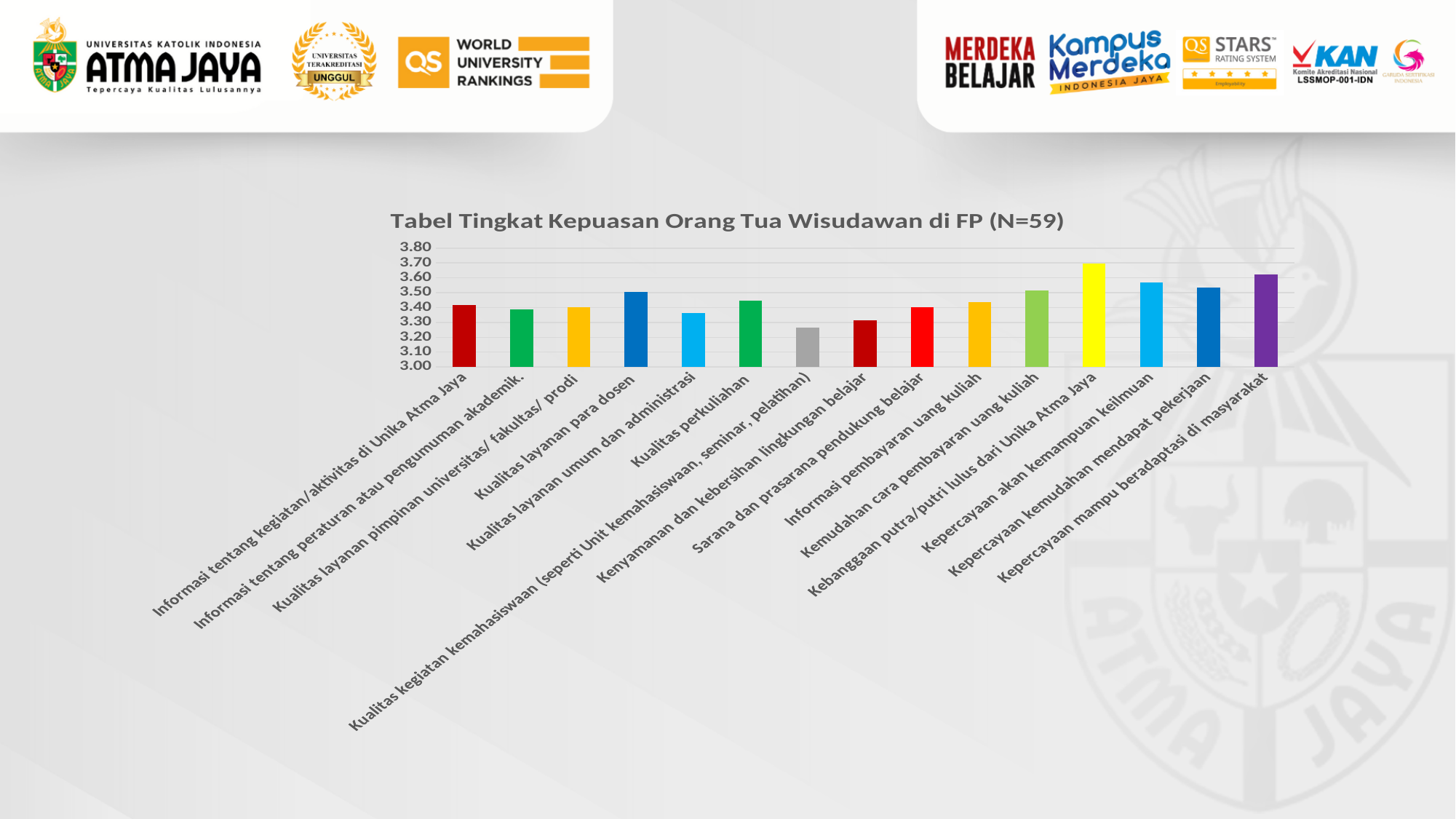
Is the value for Kualitas layanan umum dan administrasi greater or less than 3.40? less Which is larger: the value for Kualitas layanan para dosen or the value for Kualitas layanan umum dan administrasi? Kualitas layanan para dosen What is the highest value shown on the vertical axis of the chart? 3.80 Is the value for Kepercayaan mampu beradaptasi di masyarakat greater or less than 3.50? greater Which category has the lowest value in the chart? Kualitas kegiatan kemahasiswaan (seperti Unit kemahasiswaan, seminar, pelatihan) Is the value for Kualitas kegiatan kemahasiswaan (seperti Unit kemahasiswaan, seminar, pelatihan) greater or less than 3.30? less How many categories (bars) are plotted in the chart? 15 What is the title of the chart? Tabel Tingkat Kepuasan Orang Tua Wisudawan di FP (N=59) Which is larger: the value for Kepercayaan akan kemampuan keilmuan or the value for Kualitas perkuliahan? Kepercayaan akan kemampuan keilmuan Which category has the highest value in the chart? Kebanggaan putra/putri lulus dari Unika Atma Jaya What kind of chart is shown on the slide? Bar chart